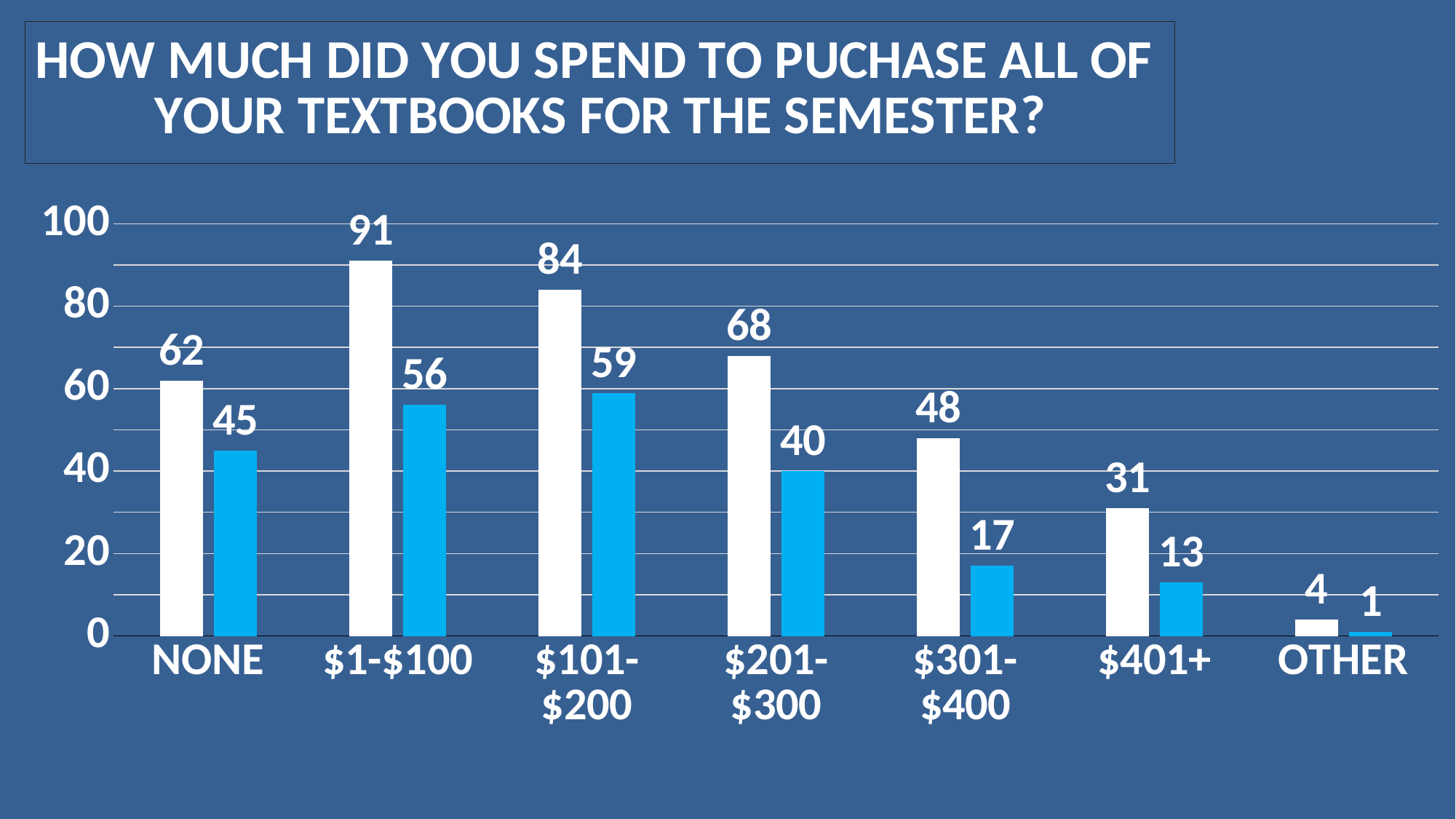
What kind of chart is shown on the slide? bar chart What is the difference between the white bar and the blue bar for $101-$200? 25 Which is larger: the blue bar for NONE or the blue bar for $301-$400? NONE Which category has the highest white bar? $1-$100 Which category has the lowest blue bar? OTHER What is the title of the chart? HOW MUCH DID YOU SPEND TO PUCHASE ALL OF YOUR TEXTBOOKS FOR THE SEMESTER? What is the value of the white bar for $1-$100? 91 How many categories are shown on the x axis? 7 What is the value of the white bar for NONE? 62 What is the difference between the white bars for $1-$100 and $401+? 60 What is the value of the blue bar for $201-$300? 40 Do the blue bars rise or fall from $101-$200 to OTHER along the x axis? fall